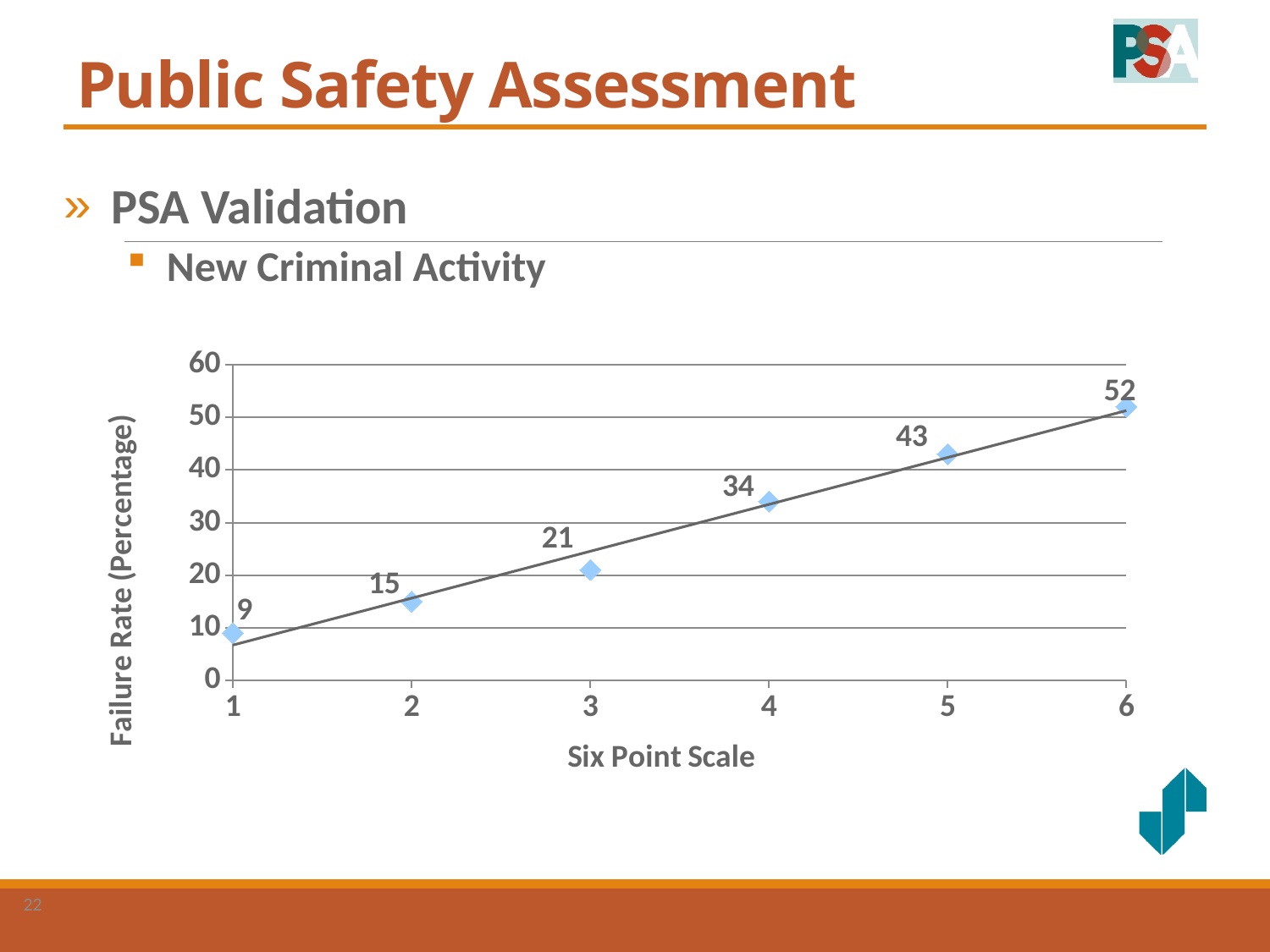
What is the failure rate for scale point 4? 34 Which point on the six point scale has the highest failure rate? 6 What is the label of the y axis? Failure Rate (Percentage) Is the failure rate for scale point 3 greater or less than 30? less What kind of chart is shown on the slide? scatter chart with a trend line Which has a higher failure rate, scale point 3 or scale point 5? 5 What is the failure rate for scale point 6? 52 What is the failure rate for scale point 1? 9 Which point on the six point scale has the lowest failure rate? 1 What is the difference between the failure rates at scale points 5 and 2? 28 How many data points are plotted on the chart? 6 Do the failure rates rise or fall as the six point scale increases? rise